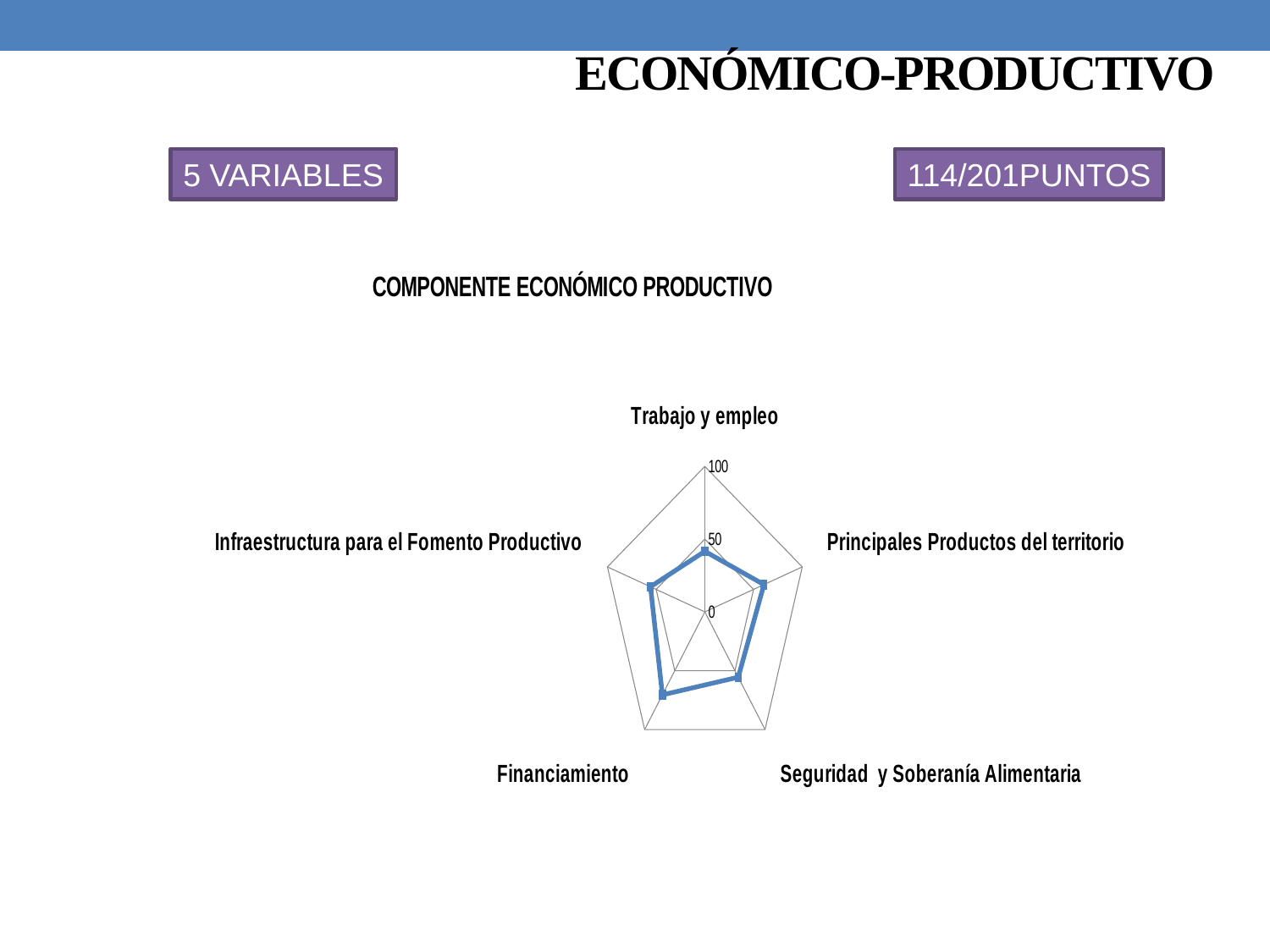
How many variables (axes) does the radar chart have? 5 What is the maximum value shown on the radar chart's axis scale? 100 Is the value for Financiamiento greater or less than 100? less Which is larger, the value for Financiamiento or the value for Trabajo y empleo? Financiamiento Which variable has the lowest value on the radar chart? Trabajo y empleo Is the value for Financiamiento greater or less than 50? greater Is the value for Trabajo y empleo greater or less than 50? less What kind of chart is shown on the slide? Radar chart What is the title of the chart? COMPONENTE ECONÓMICO PRODUCTIVO Which variable has the highest value on the radar chart? Financiamiento